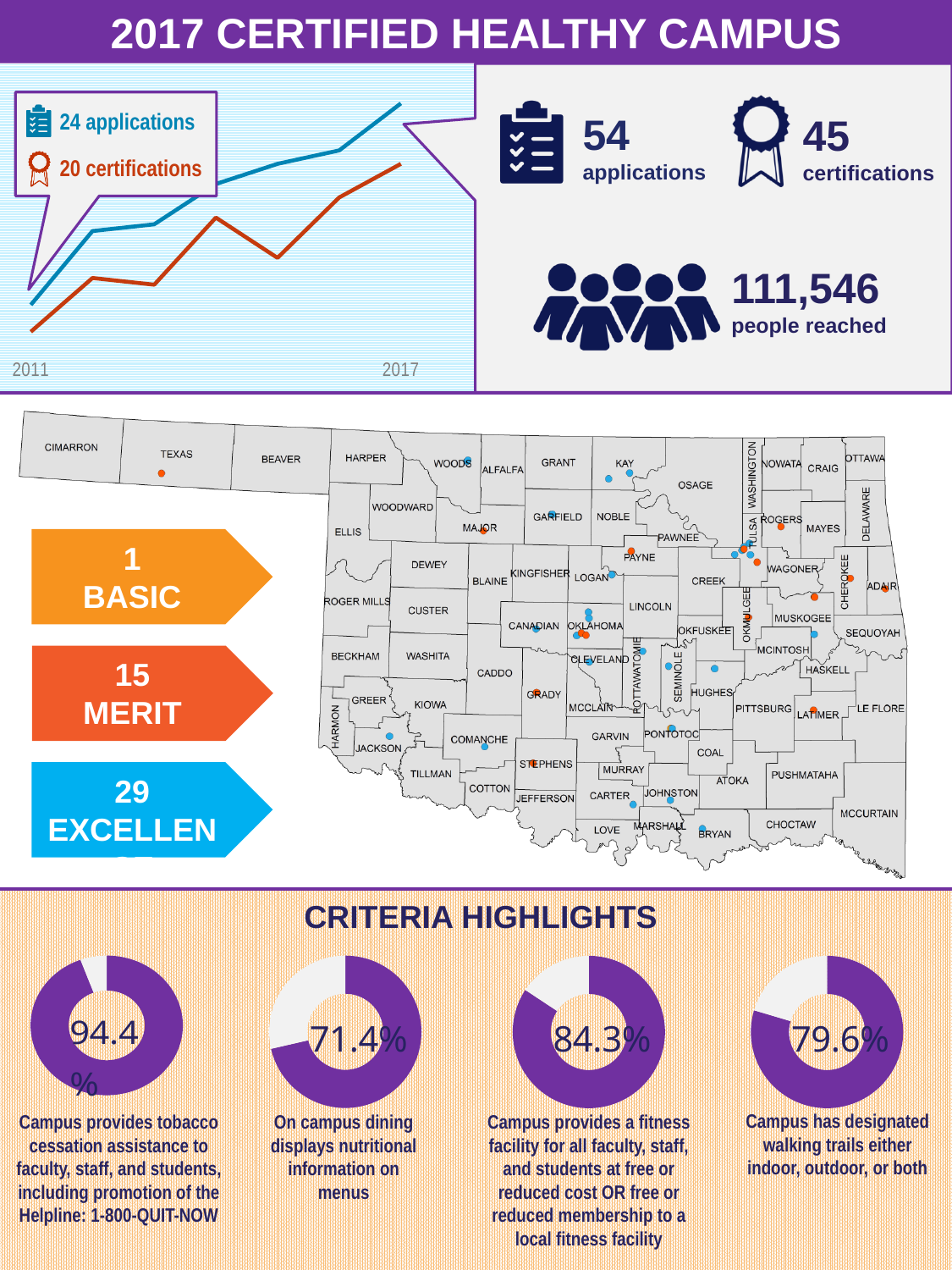
How many donut charts are shown in the Criteria Highlights section? 4 In the top-left line chart, how many applications does the callout show for 2011? 24 applications In the top-left line chart, how many certifications does the callout show for 2011? 20 certifications In the top-left line chart, which line is higher throughout, applications or certifications? applications In the Criteria Highlights section, which criterion has the highest percentage? Campus provides tobacco cessation assistance (94.4%) What kind of chart is shown in the top-left panel tracking 2011 to 2017? line chart In the top-left line chart, do the applications values rise or fall overall from 2011 to 2017? rise In the Criteria Highlights section, what kind of charts are used to show the percentages? donut charts In the Criteria Highlights section, what is the difference between the fitness facility percentage (84.3%) and the walking trails percentage (79.6%)? 4.7% Using the 2011 callout (24 applications) and the 2017 figure (54 applications), by how much did applications increase? 30 In the top-left line chart, how many lines (series) are plotted? 2 In the Criteria Highlights section, what percentage of campuses have on campus dining that displays nutritional information on menus? 71.4%